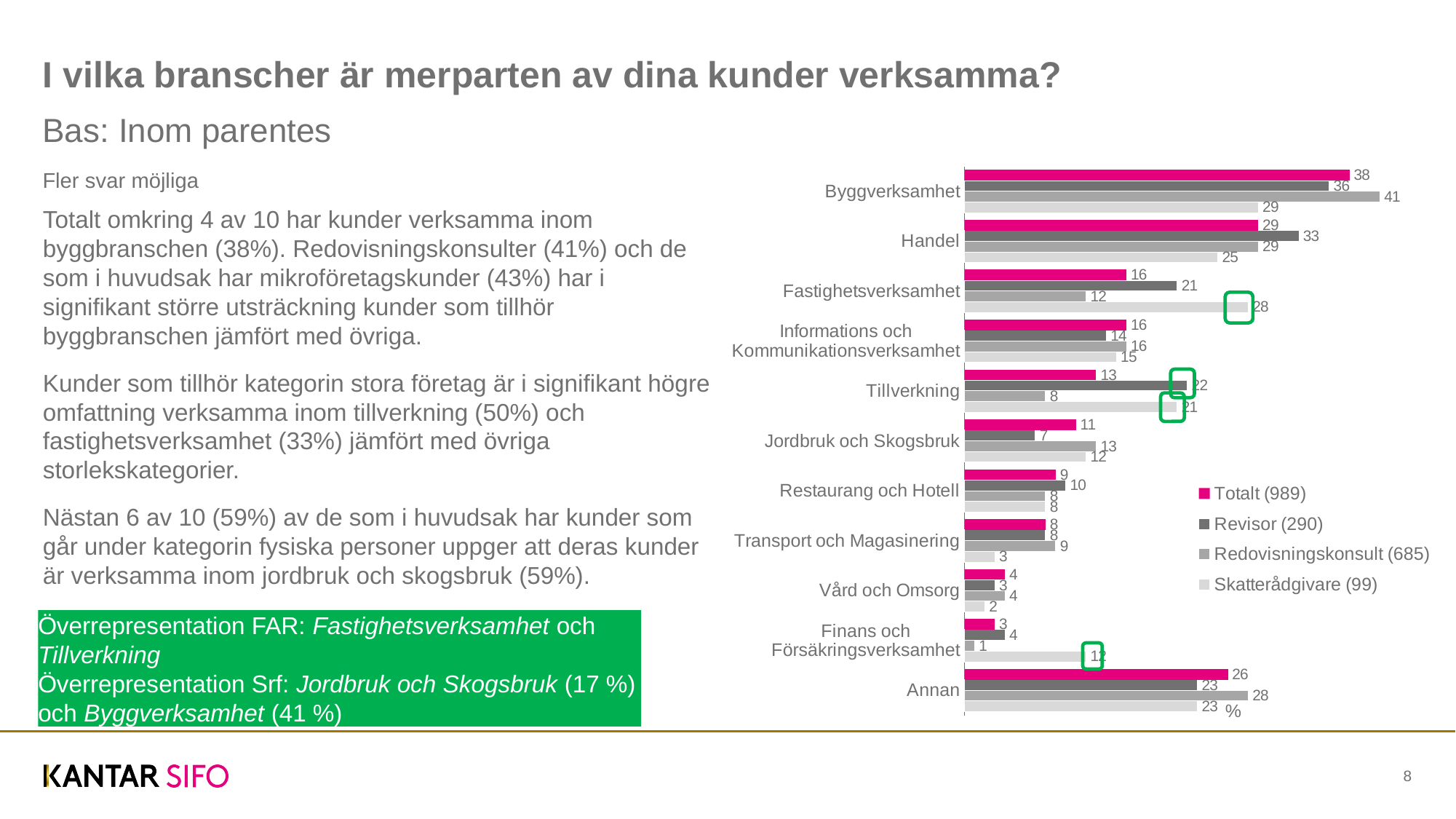
What kind of chart is shown on the slide? Bar chart For Handel, which is larger: the Revisor (290) value or the Skatterådgivare (99) value? Revisor (290) How many series does the legend list? 4 What is the difference between the Revisor (290) and Redovisningskonsult (685) values for Tillverkning? 14 What is the Totalt (989) value for Byggverksamhet? 38 How many categories are shown on the chart? 11 What is the Redovisningskonsult (685) value for Byggverksamhet? 41 What is the Revisor (290) value for Tillverkning? 22 Which category has the highest Totalt (989) value? Byggverksamhet Which category has the lowest Totalt (989) value? Finans och Försäkringsverksamhet What is the Skatterådgivare (99) value for Fastighetsverksamhet? 28 Which series is shown in pink on the chart? Totalt (989)